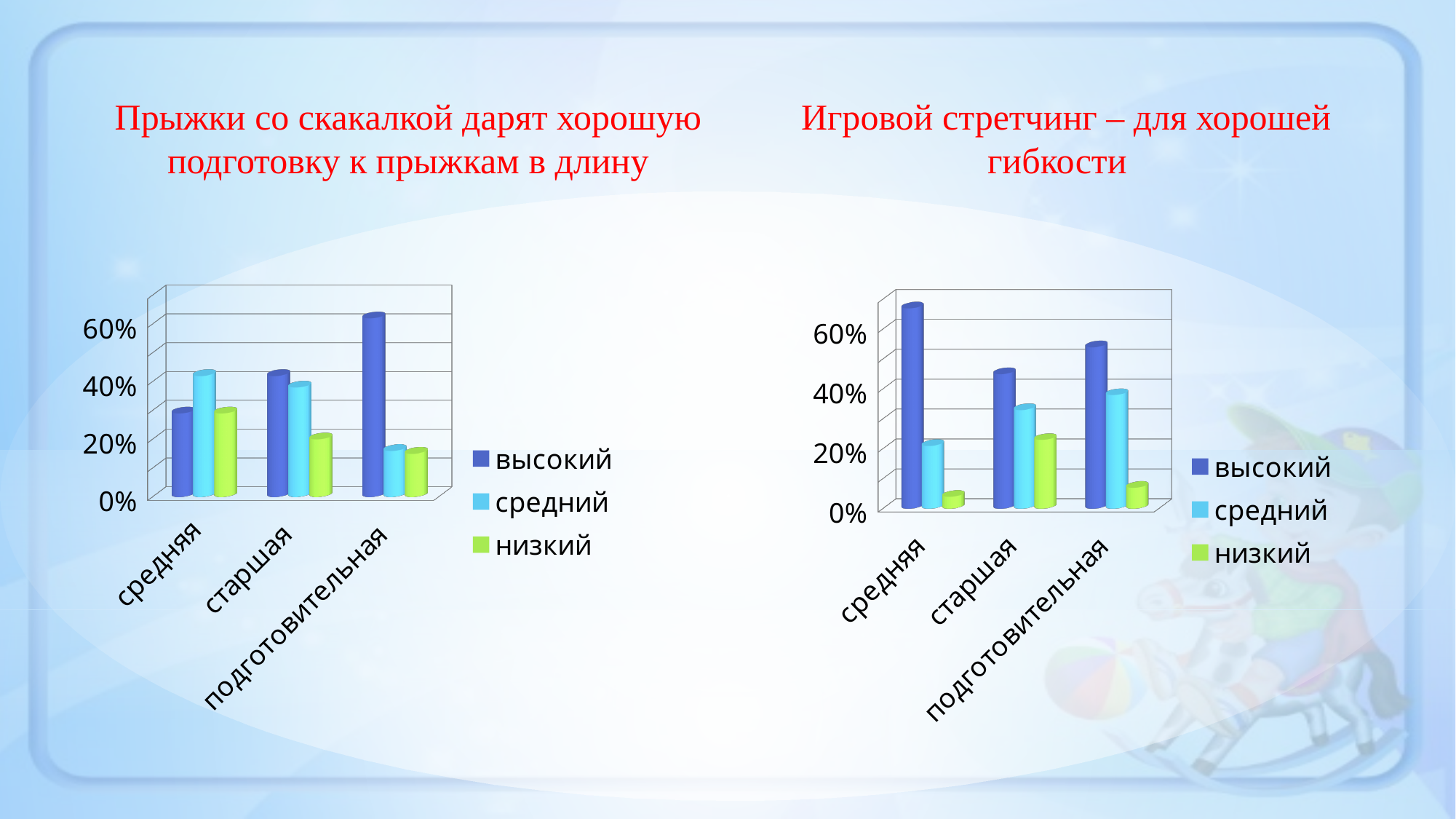
In the left chart (Прыжки со скакалкой), which series is highest for the category средняя? средний In the right chart (Игровой стретчинг), which category has the lowest низкий value? средняя In the left chart (Прыжки со скакалкой), is the value of низкий for подготовительная greater or less than 20%? less What is the title above the right chart? Игровой стретчинг – для хорошей гибкости In the right chart (Игровой стретчинг), is the value of низкий for старшая greater or less than 20%? greater In the right chart (Игровой стретчинг), is the value of высокий for средняя greater or less than 60%? greater How many series does the legend of the right chart (Игровой стретчинг) list? 3 In the left chart (Прыжки со скакалкой), which category has the highest высокий value? подготовительная How many categories are shown on the x axis of the left chart (Прыжки со скакалкой)? 3 In the right chart (Игровой стретчинг), which is larger for старшая: высокий or средний? высокий What kind of chart is the left chart (Прыжки со скакалкой)? bar chart